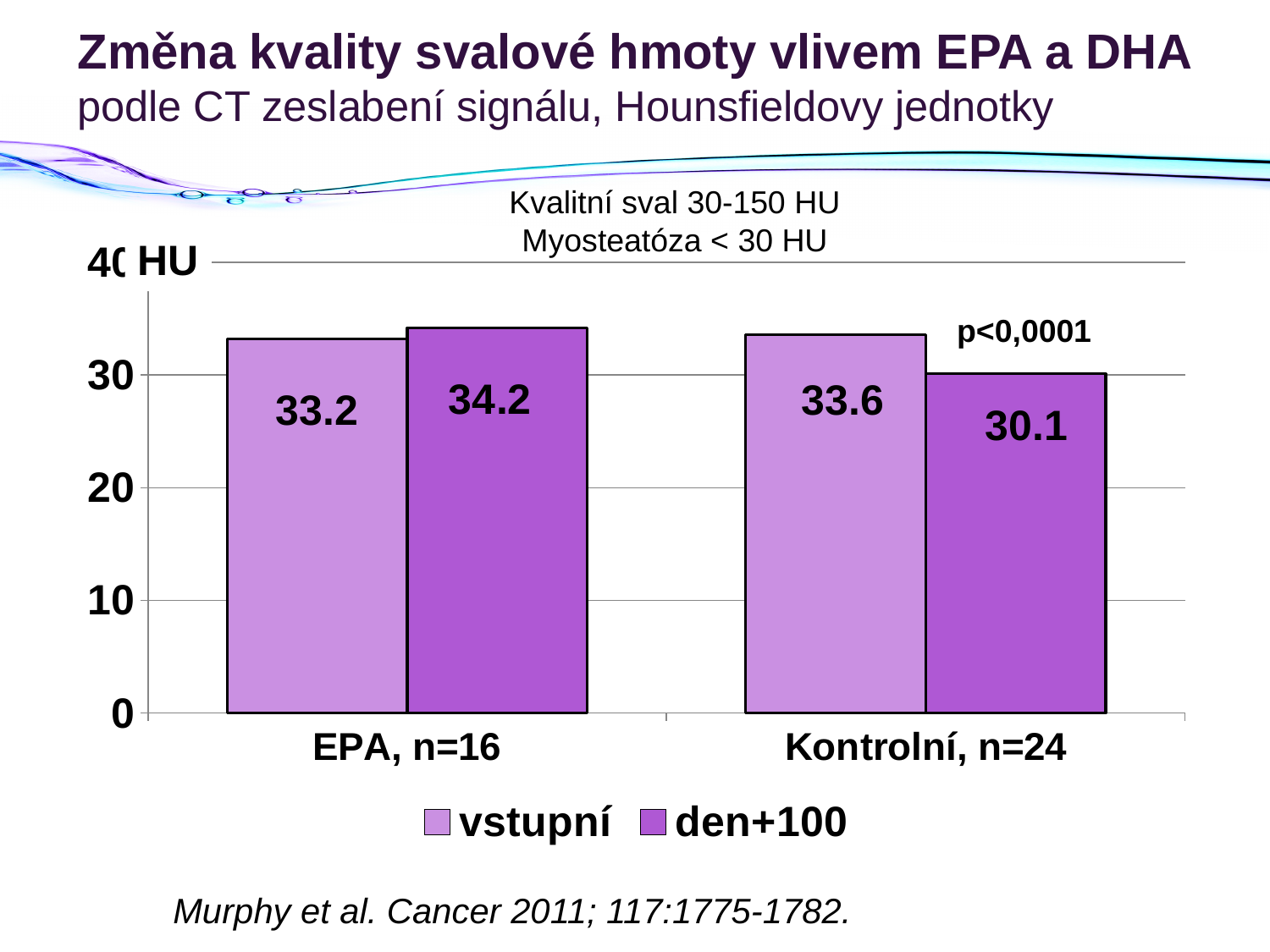
Which bar has the highest value on the chart? den+100 for EPA, n=16 (34.2) What is the 'vstupní' value for the 'EPA, n=16' group? 33.2 Which bar has the lowest value on the chart? den+100 for Kontrolní, n=24 (30.1) What is the difference between the 'vstupní' and 'den+100' values for the 'Kontrolní, n=24' group? 3.5 What kind of chart is shown on the slide? Bar chart What is the 'den+100' value for the 'EPA, n=16' group? 34.2 Which is larger: the 'den+100' value for 'EPA, n=16' or the 'den+100' value for 'Kontrolní, n=24'? EPA, n=16 What is the 'den+100' value for the 'Kontrolní, n=24' group? 30.1 How many groups are shown on the x axis? 2 What is the 'vstupní' value for the 'Kontrolní, n=24' group? 33.6 How many series does the legend list? 2 What is the difference between the 'den+100' and 'vstupní' values for the 'EPA, n=16' group? 1.0